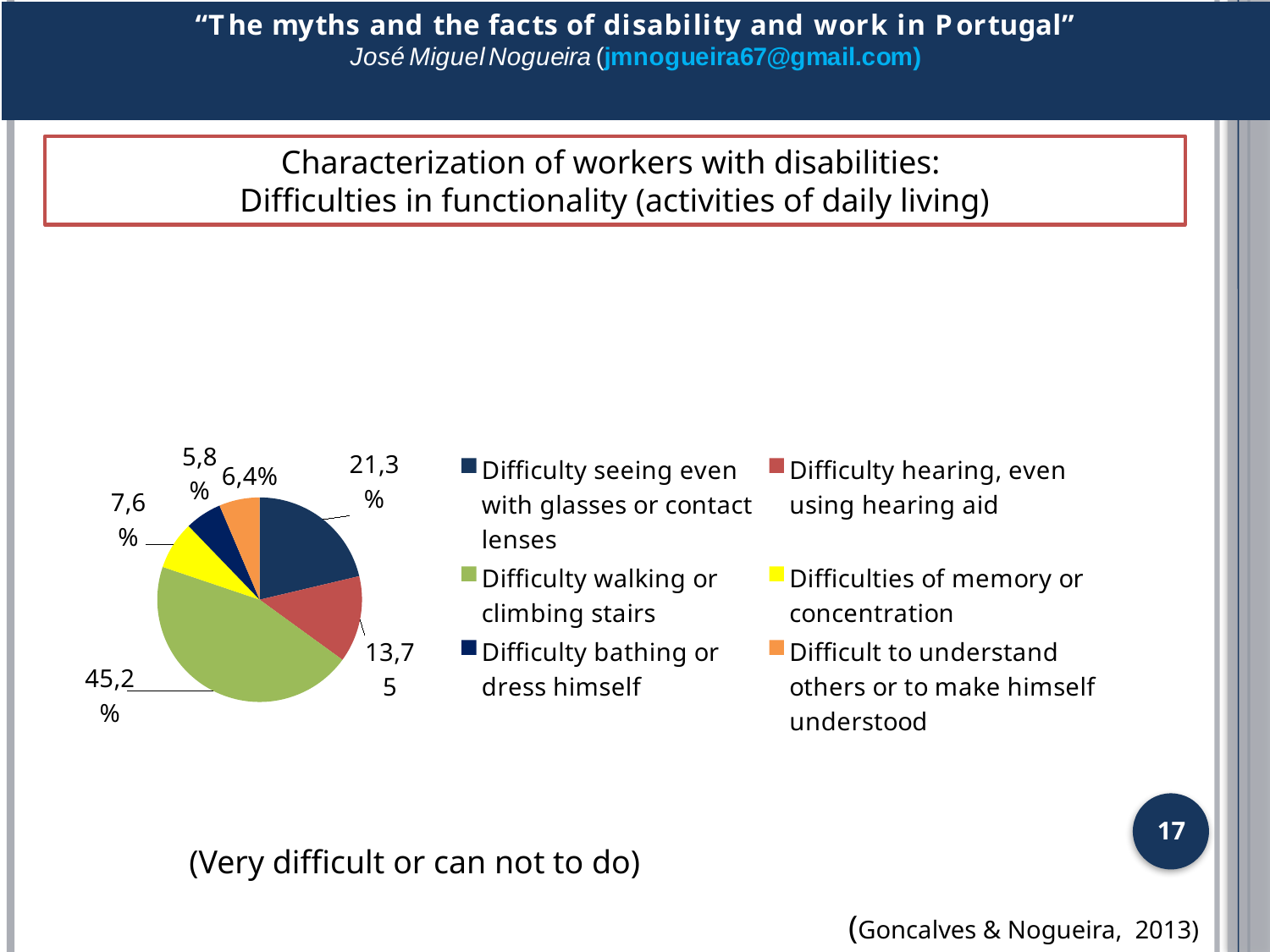
What percentage is shown for 'Difficult to understand others or to make himself understood'? 6,4% Which difficulty has the smallest slice of the pie chart? Difficulty bathing or dress himself Which is larger: the slice for 'Difficulties of memory or concentration' or the slice for 'Difficult to understand others or to make himself understood'? Difficulties of memory or concentration Which difficulty has the largest slice of the pie chart? Difficulty walking or climbing stairs What percentage is shown for 'Difficulty walking or climbing stairs'? 45,2% What percentage is shown for 'Difficulties of memory or concentration'? 7,6% What percentage is shown for 'Difficulty bathing or dress himself'? 5,8% What is the difference in percentage points between 'Difficulty walking or climbing stairs' and 'Difficulty seeing even with glasses or contact lenses'? 23,9 How many entries does the legend of the pie chart list? 6 What percentage is shown for 'Difficulty seeing even with glasses or contact lenses'? 21,3% How many slices does the pie chart have? 6 What kind of chart is shown on the slide? pie chart